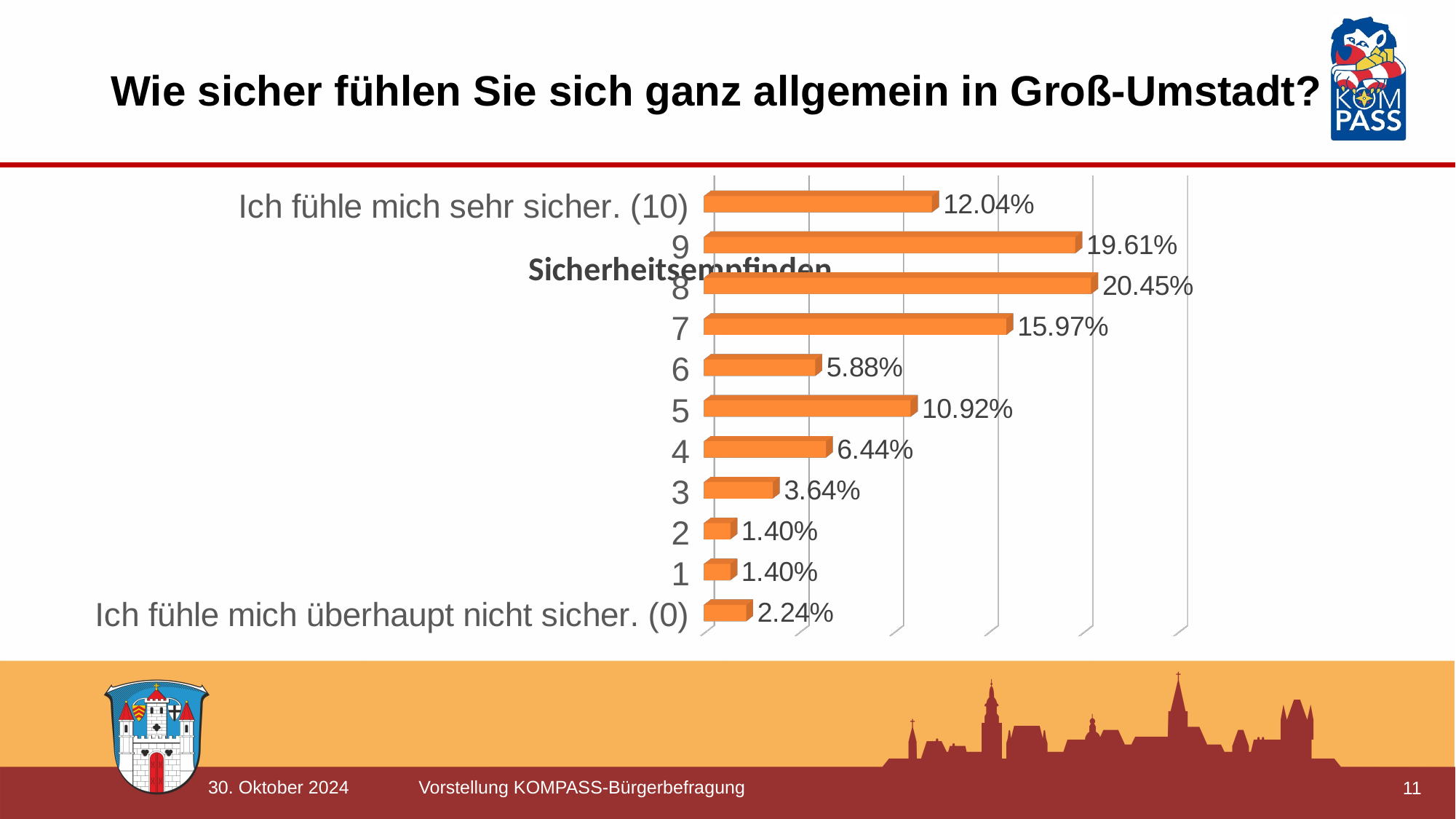
What is the combined value of categories 1 and 2? 2.80% Which category has the highest value? 8 What colour are the bars in the chart? Orange What percentage of respondents chose "Ich fühle mich sehr sicher. (10)"? 12.04% What kind of chart is shown on the slide? Bar chart What is the value shown for category 8? 20.45% Which is larger, the value for category 5 or the value for category 4? 5 What is the value shown for category 6? 5.88% How many categories are shown in the chart? 11 What is the difference between the values for category 9 and category 7? 3.64% What percentage is shown for "Ich fühle mich überhaupt nicht sicher. (0)"? 2.24%